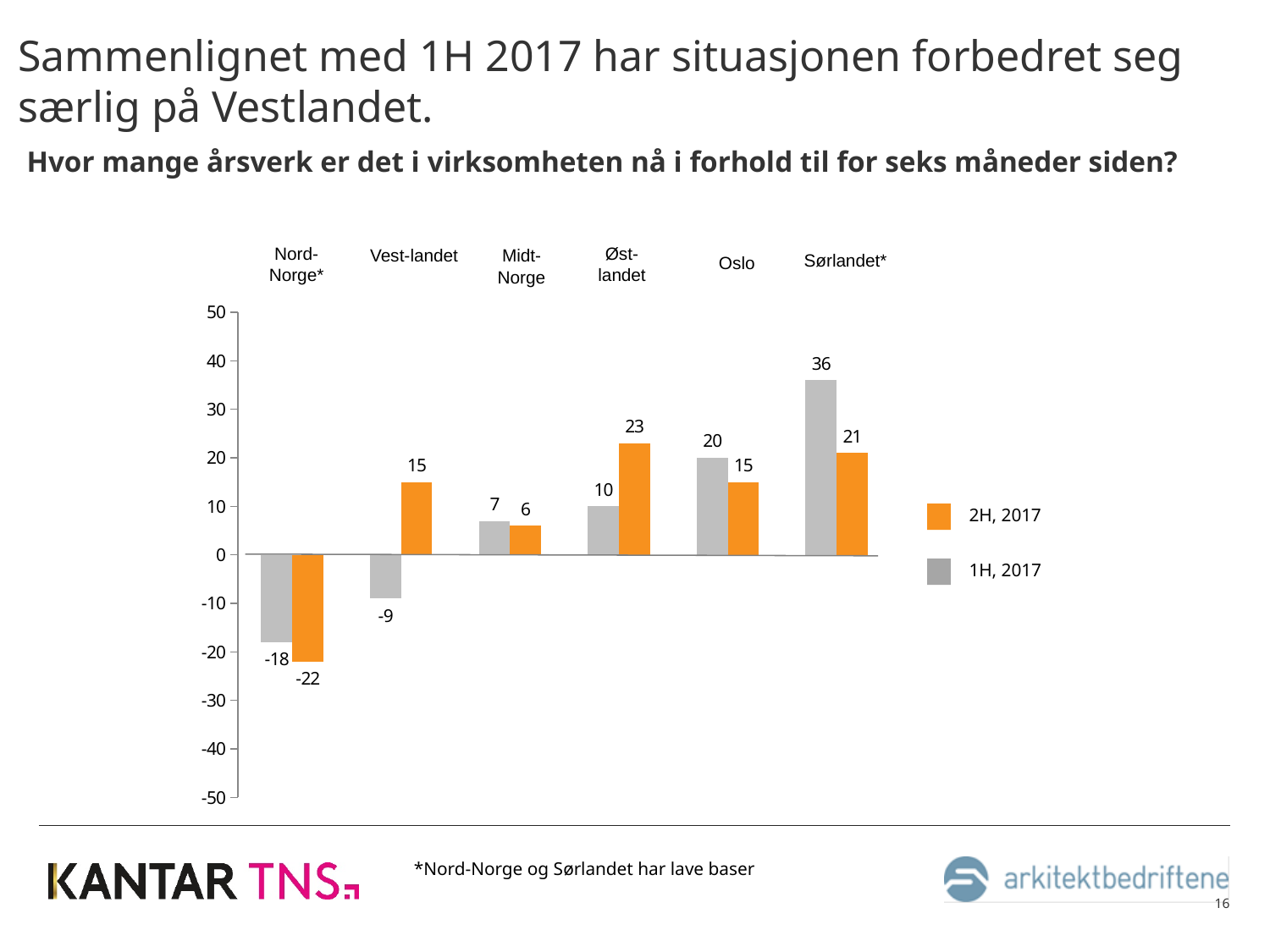
Which colour represents the 2H, 2017 series in the chart? Orange Which is larger for Øst-landet: the 1H, 2017 value or the 2H, 2017 value? 2H, 2017 What kind of chart is shown on the slide? Bar chart How many regions are shown on the x axis of the chart? 6 Which region has the highest value in the 2H, 2017 series? Øst-landet What is the value for Sørlandet* in the 1H, 2017 series? 36 What is the value for Vest-landet in the 2H, 2017 series? 15 What is the value for Oslo in the 1H, 2017 series? 20 What is the difference between the 1H, 2017 and 2H, 2017 values for Sørlandet*? 15 How many series does the legend list? 2 What is the value for Nord-Norge* in the 2H, 2017 series? -22 Which region has the lowest value in the 1H, 2017 series? Nord-Norge*